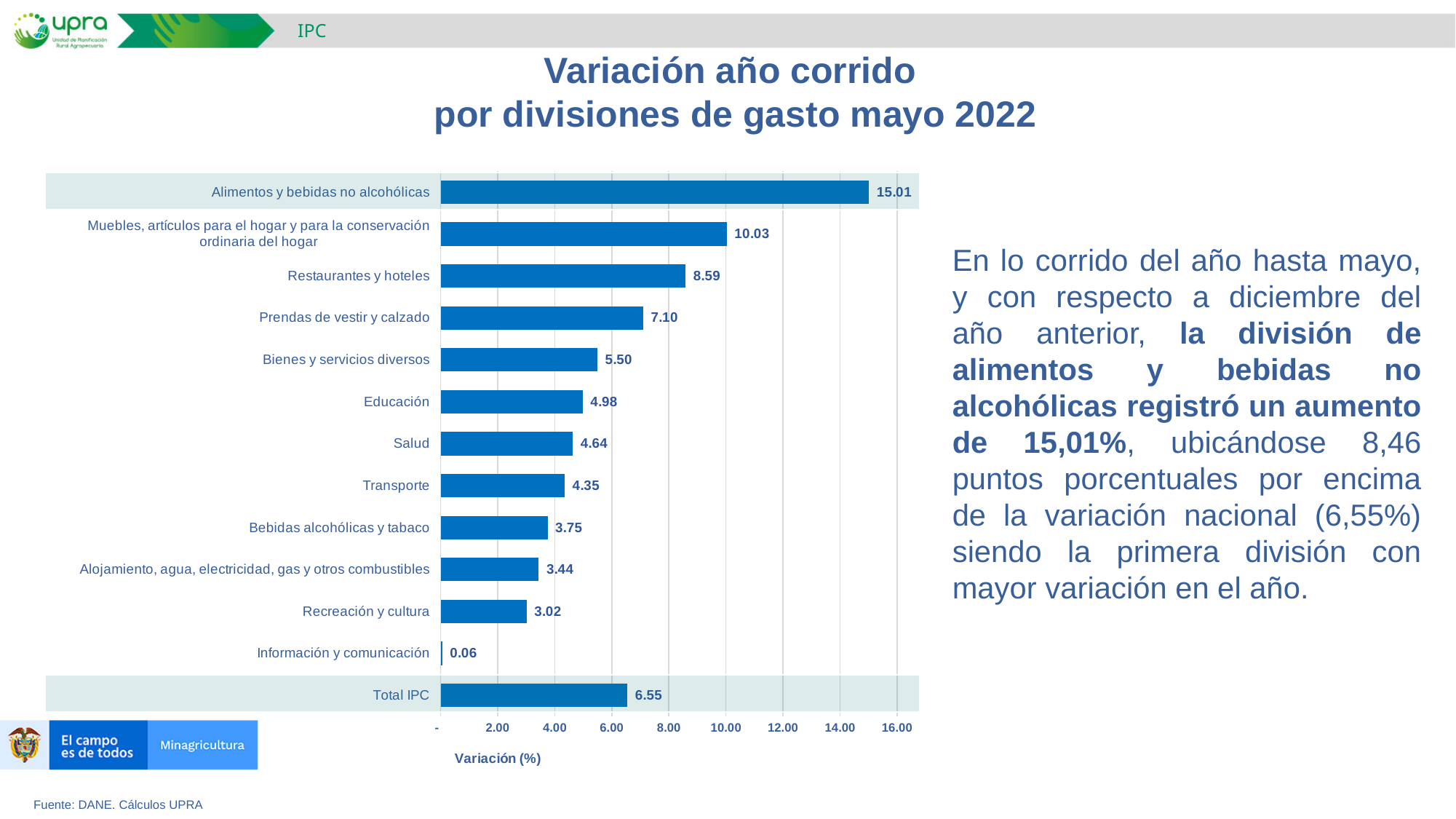
What kind of chart is shown on the slide? Bar chart Which is larger, the value for Salud or the value for Transporte? Salud What is the value for Alimentos y bebidas no alcohólicas? 15.01 What is the value for Restaurantes y hoteles? 8.59 What is the value for Total IPC? 6.55 Which category has the lowest value? Información y comunicación What is the value for Información y comunicación? 0.06 Which category has the highest value? Alimentos y bebidas no alcohólicas How many categories are shown on the chart? 13 What is the label of the horizontal axis? Variación (%) Is the value for Muebles, artículos para el hogar y para la conservación ordinaria del hogar greater or less than 8.00? greater What is the difference between the values for Alimentos y bebidas no alcohólicas and Total IPC? 8.46